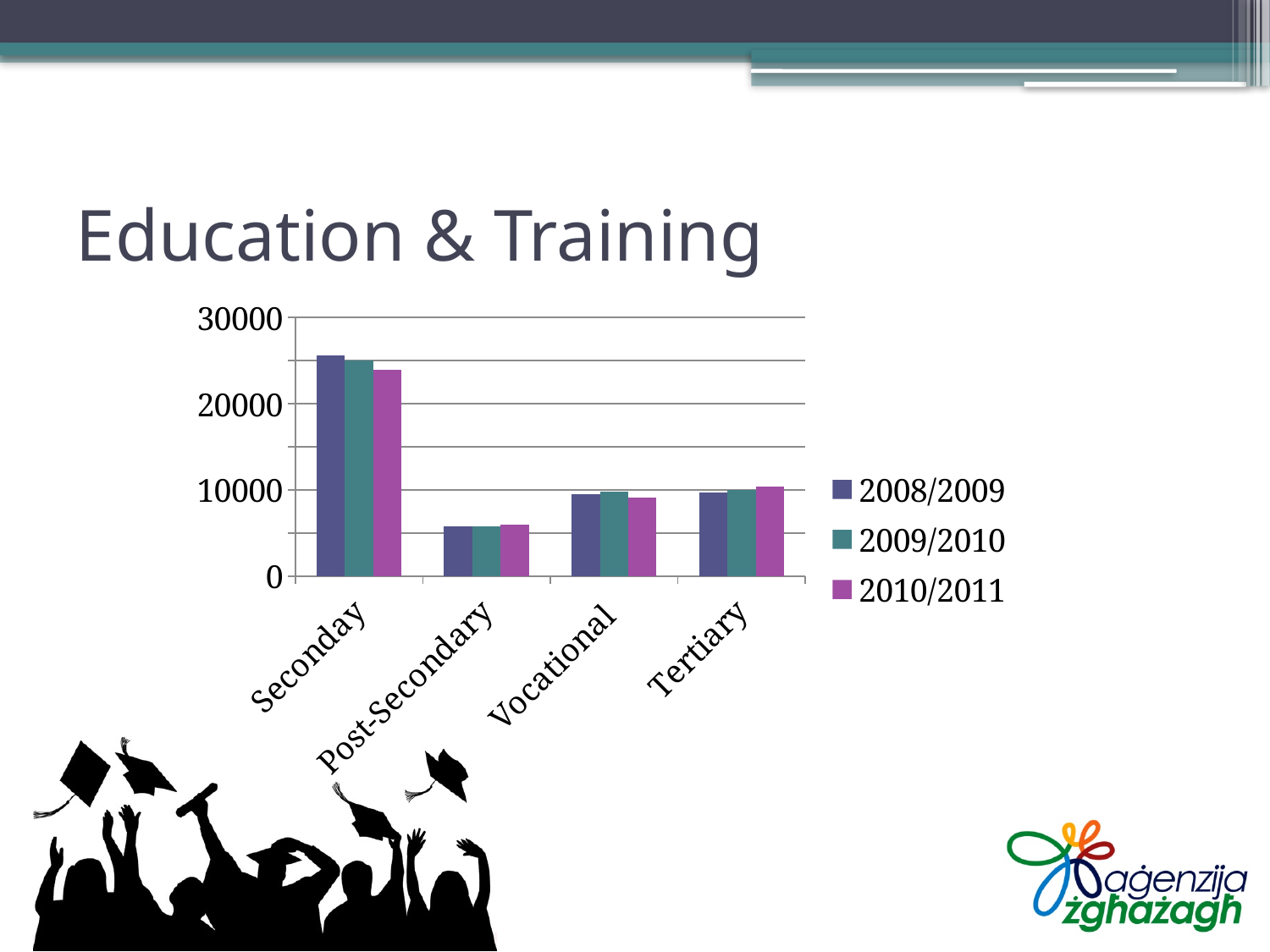
Do the values for Seconday rise or fall from 2008/2009 to 2010/2011? fall How many series does the chart's legend list? 3 Which is larger in 2008/2009: the value for Seconday or the value for Tertiary? Seconday What is the title of the slide containing the chart? Education & Training Which category has the highest bars in the chart? Seconday How many categories are shown on the x axis of the chart? 4 Is the value for Seconday in 2008/2009 greater or less than 20000? greater Which category has the lowest bars in the chart? Post-Secondary Is the value for Vocational in 2010/2011 greater or less than 10000? less What kind of chart is shown on the slide? bar chart What are the three series listed in the chart's legend? 2008/2009, 2009/2010, 2010/2011 Is the value for Post-Secondary in 2010/2011 greater or less than 10000? less